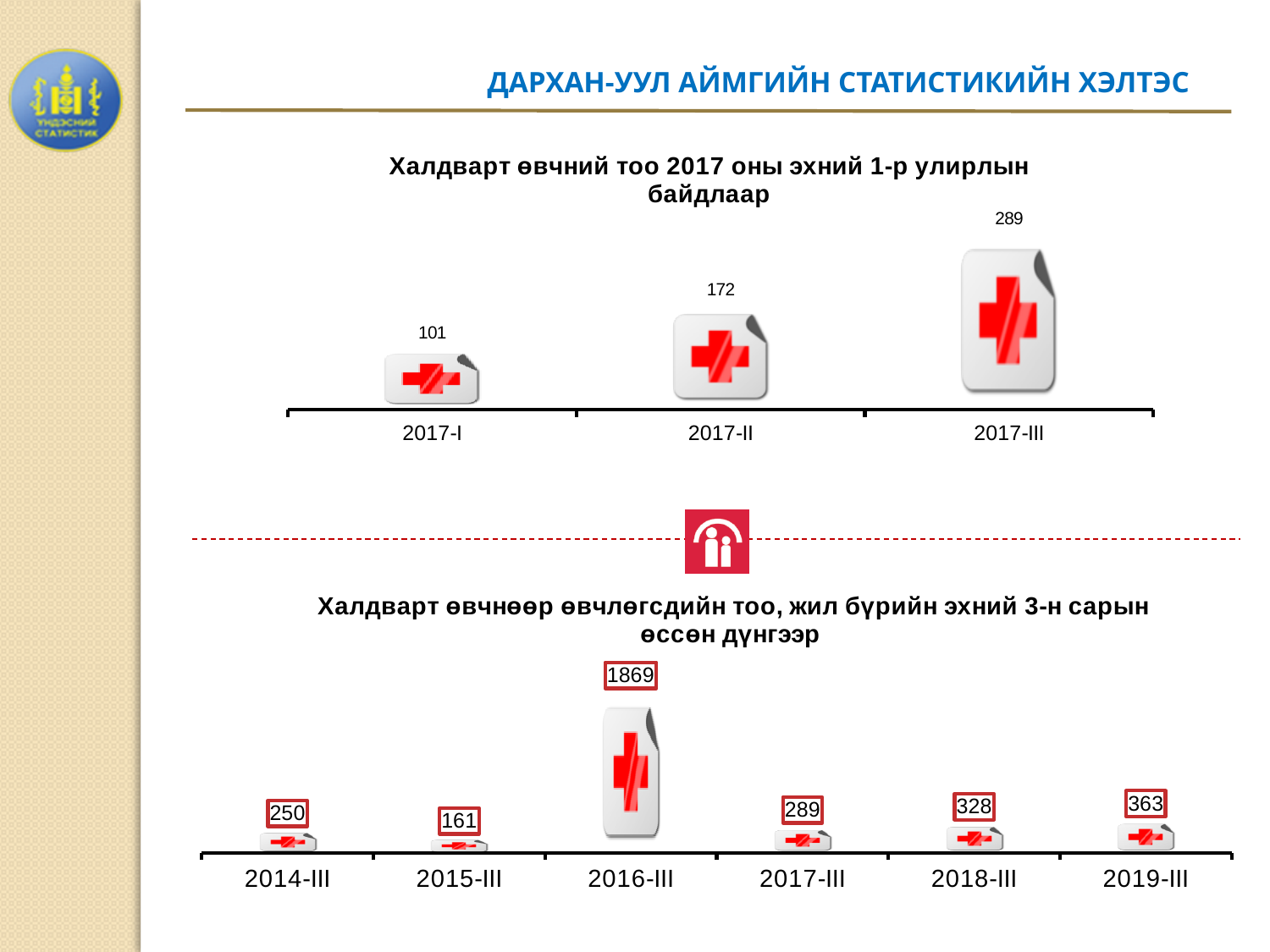
In the bottom chart, which is larger, the value for 2018-III or the value for 2017-III? 2018-III In the top chart, what is the value for 2017-I? 101 In the bottom chart, what is the difference between the values for 2014-III and 2015-III? 89 In the bottom chart, what is the value for 2016-III? 1869 In the top chart, how many categories are shown on the x axis? 3 In the top chart, what is the difference between the values for 2017-III and 2017-I? 188 In the bottom chart, what is the value for 2019-III? 363 In the top chart, which category has the highest value? 2017-III In the bottom chart, which category has the lowest value? 2015-III In the top chart, what is the value for 2017-II? 172 In the bottom chart, how many categories are shown on the x axis? 6 In the top chart, do the values rise or fall from 2017-I to 2017-III? rise